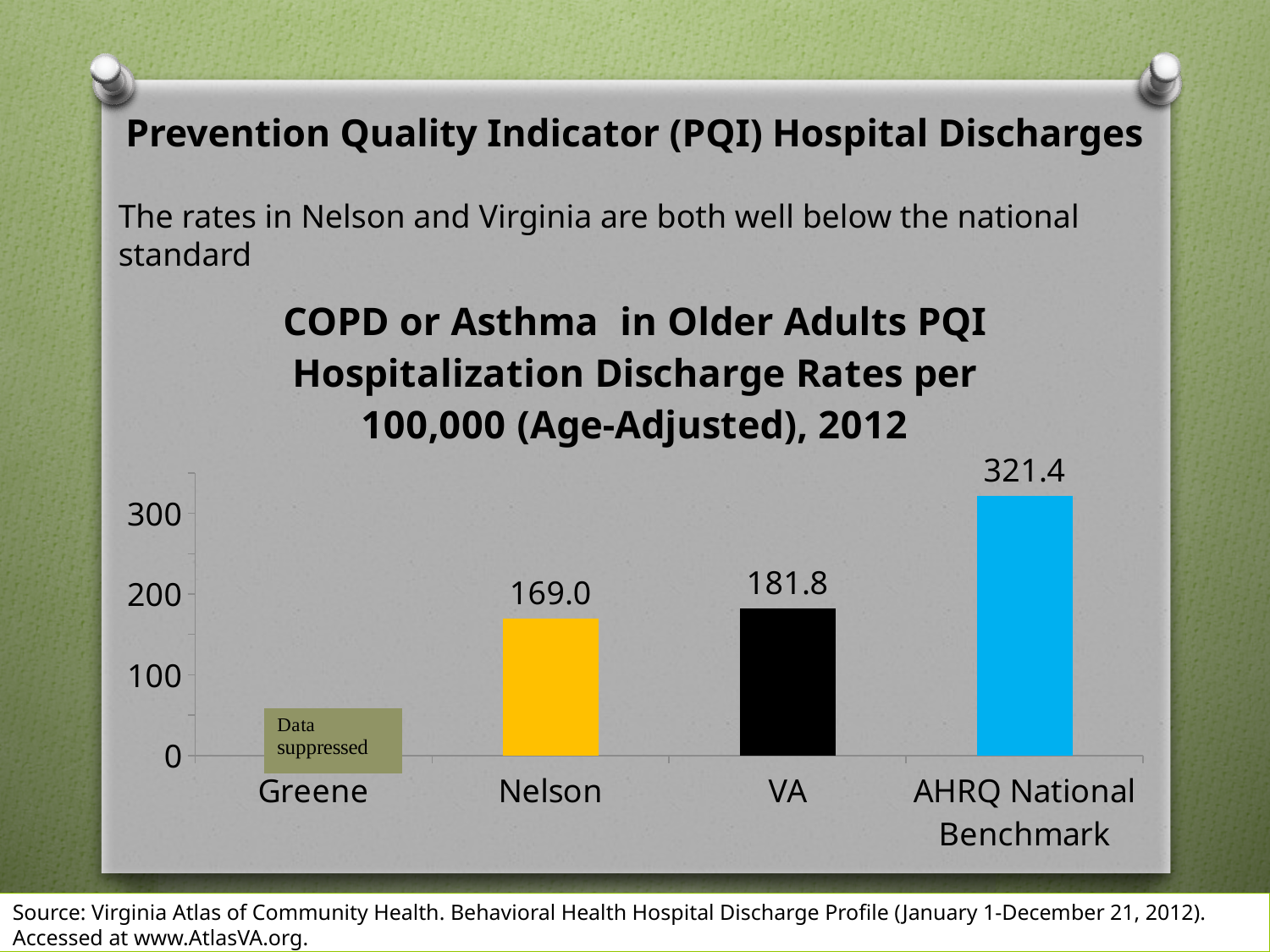
What is the COPD or Asthma PQI hospitalization discharge rate for VA? 181.8 What kind of chart is shown on the slide? bar chart Which is larger, the rate for Nelson or the rate for VA? VA What colour is the bar for the AHRQ National Benchmark? blue Which category has the highest discharge rate on the chart? AHRQ National Benchmark What is the difference between the AHRQ National Benchmark rate and the VA rate? 139.6 What is shown in place of a value for Greene on the chart? Data suppressed How many categories are shown on the x axis of the chart? 4 What is the COPD or Asthma PQI hospitalization discharge rate for Nelson? 169.0 What is the value shown for the AHRQ National Benchmark? 321.4 What is the difference between the VA rate and the Nelson rate? 12.8 Is the value for the AHRQ National Benchmark greater or less than 300? greater